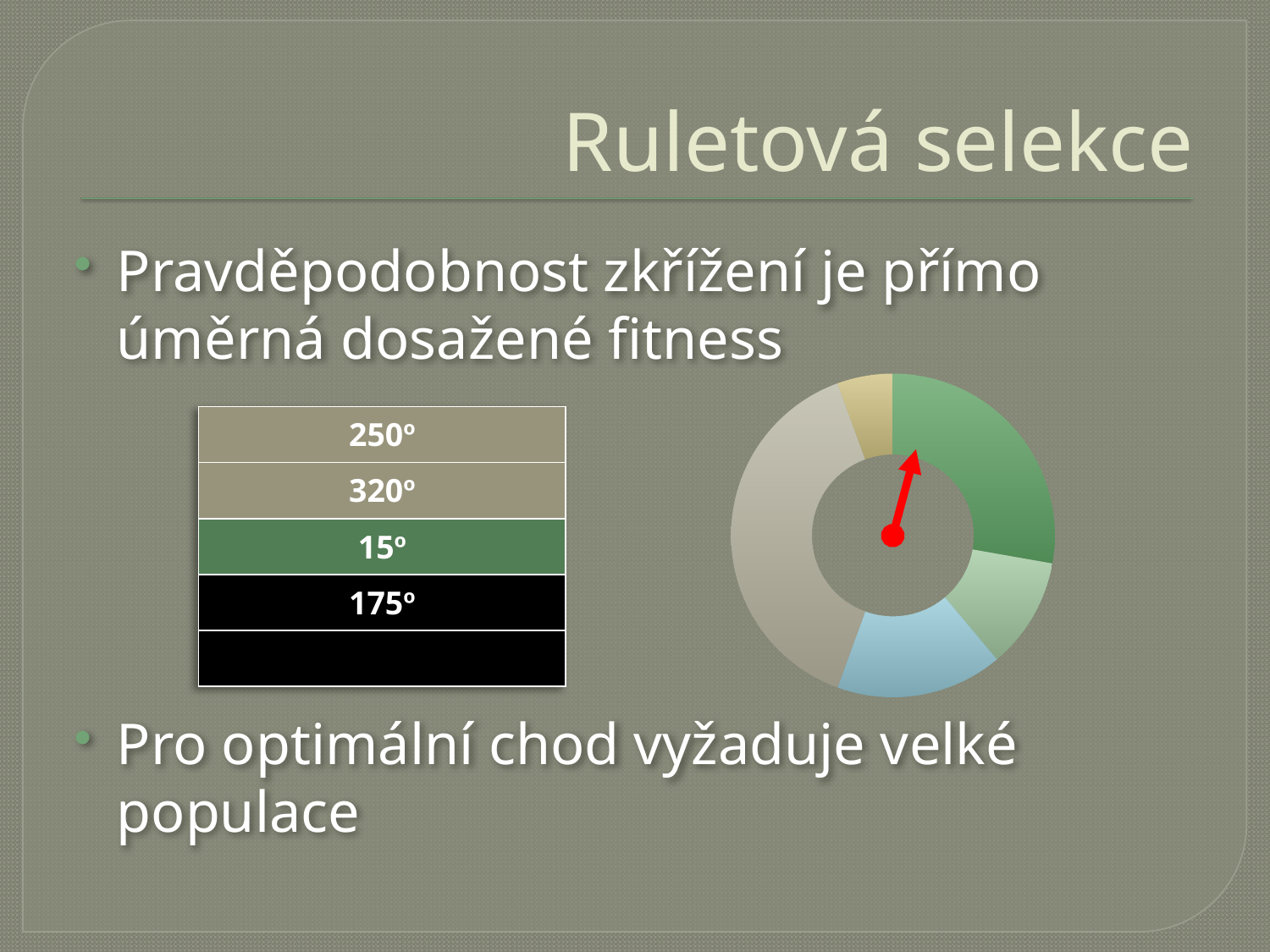
What kind of chart is shown on the right side of the slide? Doughnut chart Which slice of the doughnut chart is the largest? The grey-beige slice In the doughnut chart, which is larger: the grey-beige slice or the dark green slice? The grey-beige slice In the doughnut chart, which is larger: the dark green slice or the light blue slice? The dark green slice Which slice of the doughnut chart does the red arrow point into? The dark green slice Does the doughnut chart on the slide display a legend? No How many slices does the doughnut chart on the slide have? 5